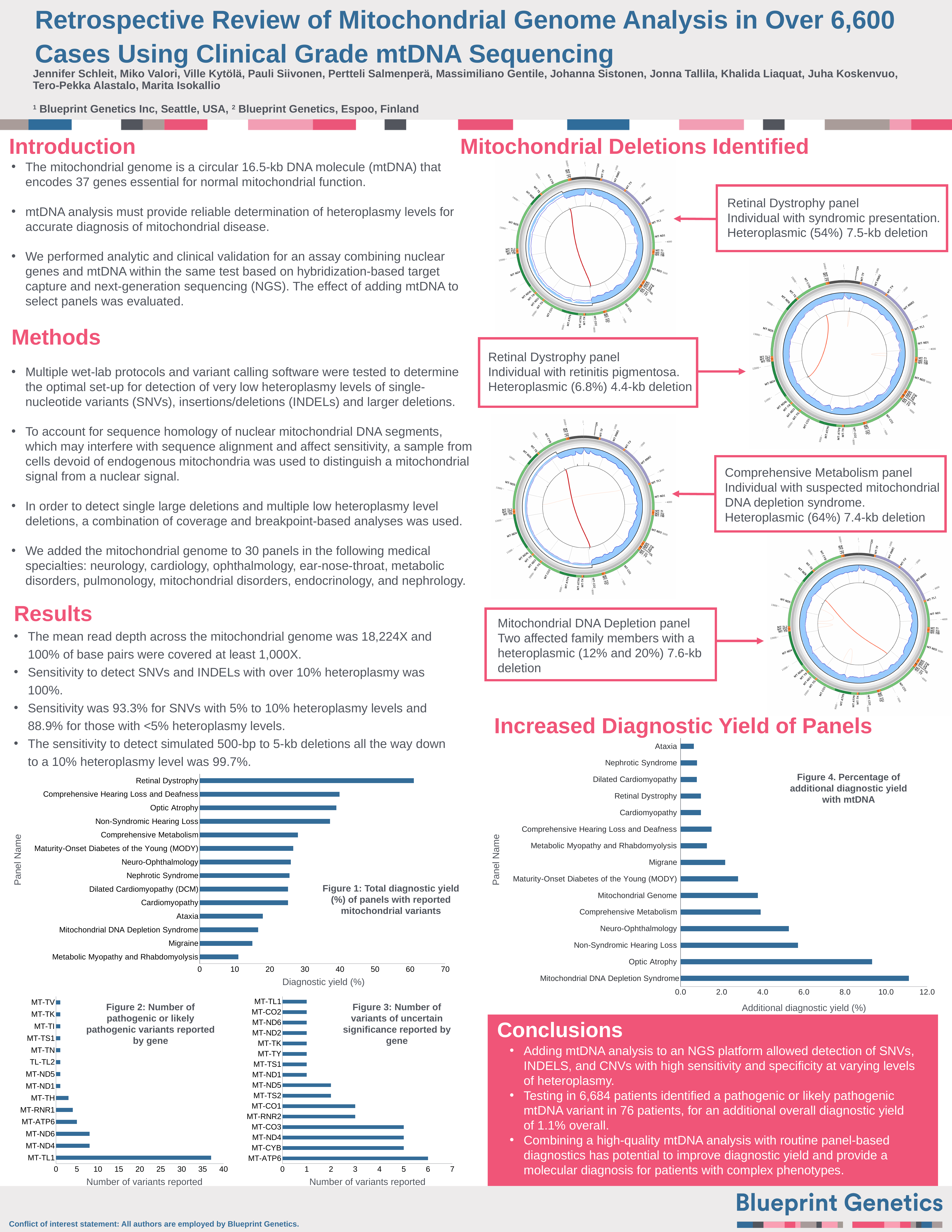
In Figure 2 (pathogenic or likely pathogenic variants by gene), is the number of variants for MT-TL1 greater or less than 30? greater In Figure 3 (variants of uncertain significance by gene), which gene has the most variants reported? MT-ATP6 In Figure 1 (Total diagnostic yield of panels), which panel has the lowest diagnostic yield? Metabolic Myopathy and Rhabdomyolysis In Figure 1 (Total diagnostic yield of panels), which panel has the highest diagnostic yield? Retinal Dystrophy In Figure 4 (additional diagnostic yield with mtDNA), which panel has the highest additional diagnostic yield? Mitochondrial DNA Depletion Syndrome In Figure 3 (variants of uncertain significance by gene), how many genes are plotted? 16 In Figure 1 (Total diagnostic yield of panels), is the diagnostic yield for Retinal Dystrophy greater or less than 50? greater In Figure 1 (Total diagnostic yield of panels), how many panels are plotted? 14 In Figure 4 (additional diagnostic yield with mtDNA), is the additional diagnostic yield for Optic Atrophy greater or less than 8.0? greater What type of chart is Figure 4 (additional diagnostic yield with mtDNA)? bar chart